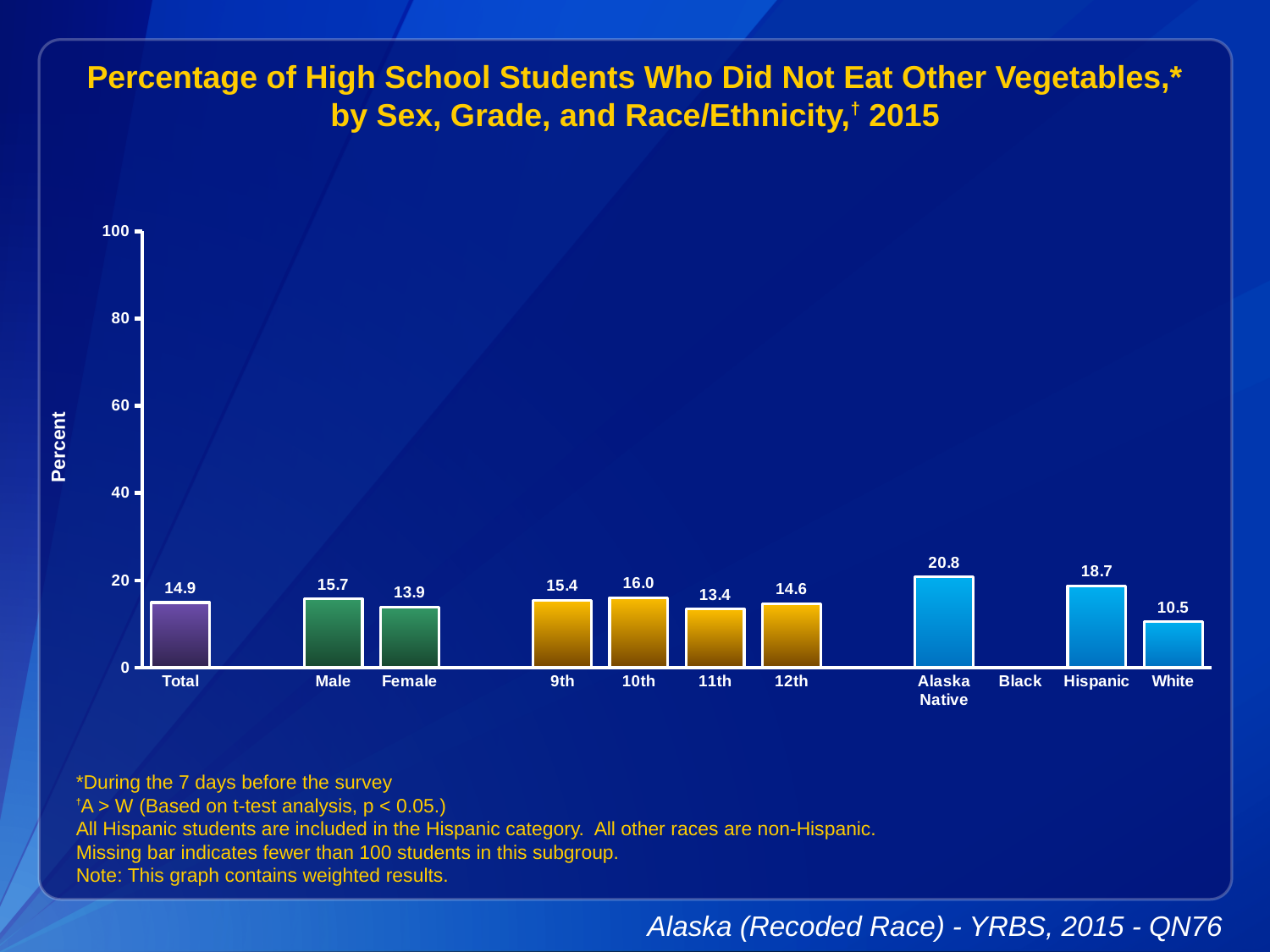
Is the value for Hispanic greater or less than 20? less Which category has no bar shown? Black What is the value for Alaska Native? 20.8 Which is larger, the value for 10th or the value for 11th? 10th Which category has the highest value? Alaska Native What is the value for Total? 14.9 How many categories are labeled on the x axis? 11 What is the label of the y axis? Percent What is the difference between the values for Male and Female? 1.8 What is the value for Female? 13.9 Which category has the lowest value among those with a bar? White What kind of chart is shown? bar chart